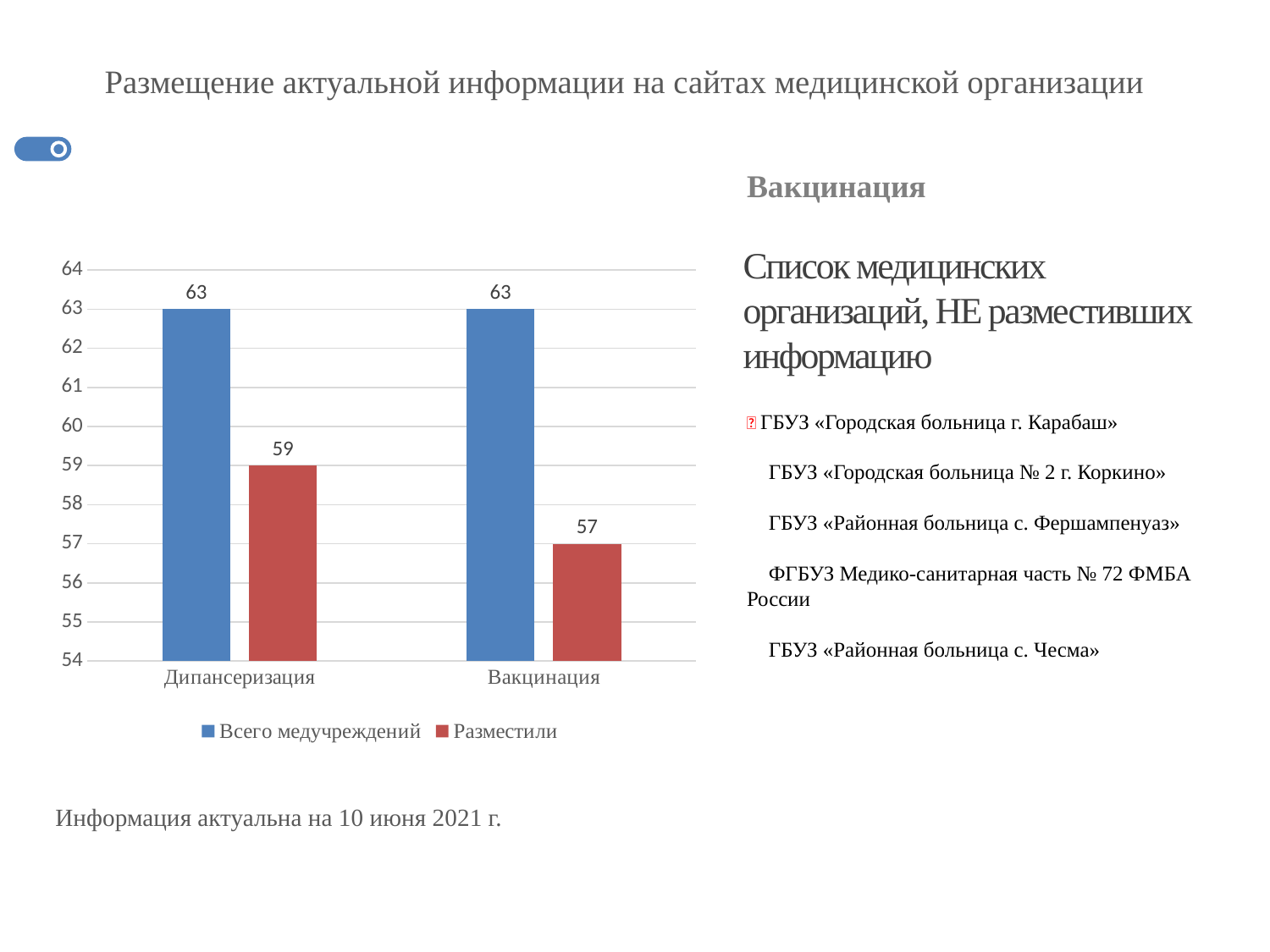
How many categories are shown on the x axis of the chart? 2 What is the value of "Разместили" for Вакцинация? 57 For which category is the "Разместили" value lowest? Вакцинация What kind of chart is shown on the slide? bar chart What is the difference between "Всего медучреждений" and "Разместили" for Дипансеризация? 4 Which is larger: "Разместили" for Дипансеризация or "Разместили" for Вакцинация? Дипансеризация What is the difference between "Всего медучреждений" and "Разместили" for Вакцинация? 6 Is the "Разместили" value for Вакцинация greater or less than 60? less What is the value of "Всего медучреждений" for Вакцинация? 63 What is the value of "Всего медучреждений" for Дипансеризация? 63 What is the value of "Разместили" for Дипансеризация? 59 How many series does the chart legend list? 2